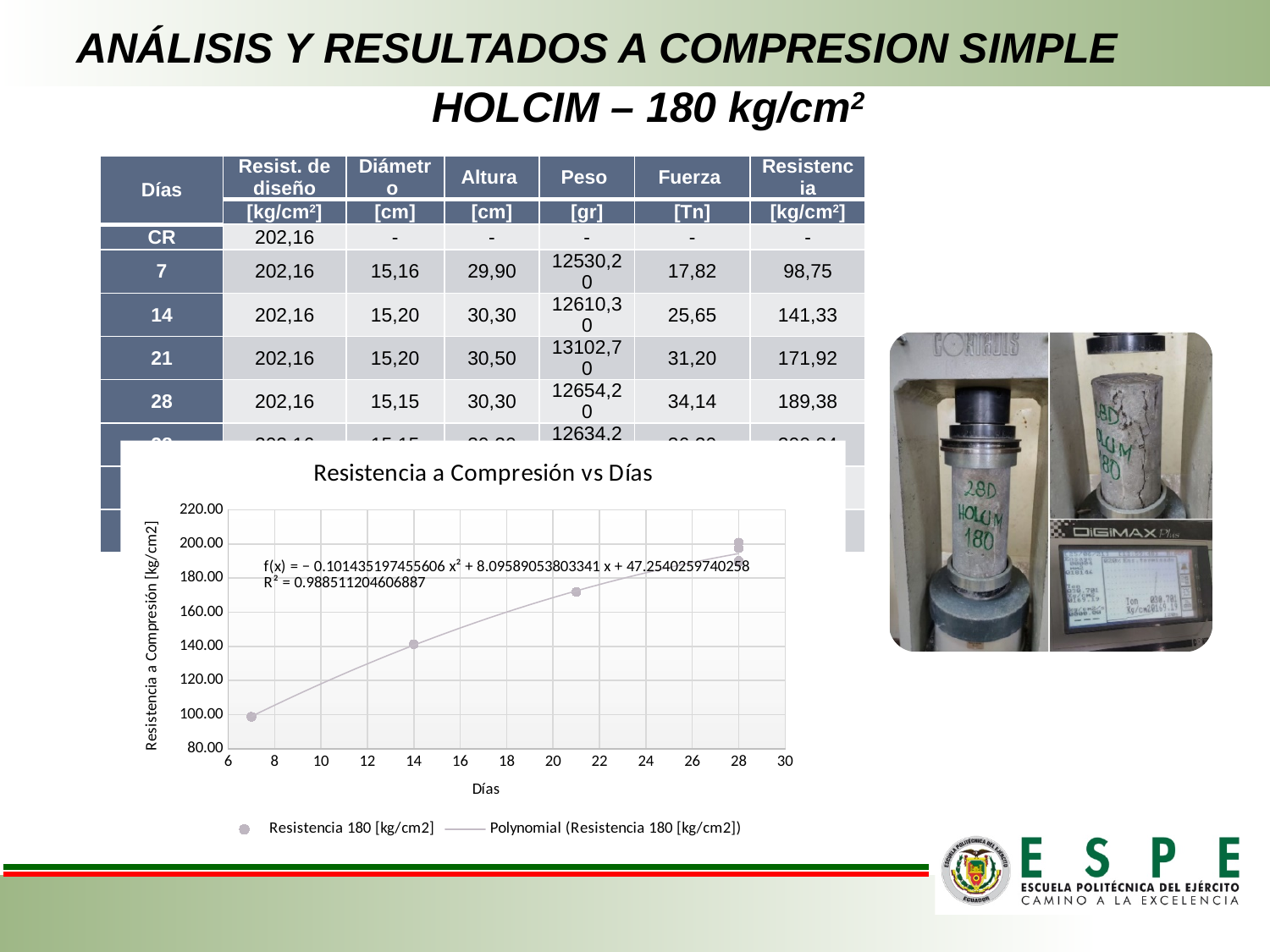
What kind of chart is shown on the slide? scatter chart Is the value plotted at 14 days greater or less than 120.00? greater How many entries does the chart legend list? 2 Is the value plotted at 7 days greater or less than 80.00? greater Is the value plotted at 21 days greater or less than 160.00? greater Which plotted value is larger, the one at 14 days or the one at 21 days? 21 days What R² value is printed on the chart for the polynomial trendline? 0.988511204606887 At which number of days is the lowest plotted value found? 7 What is the title of the chart? Resistencia a Compresión vs Días Do the plotted values rise or fall as the number of days increases? rise